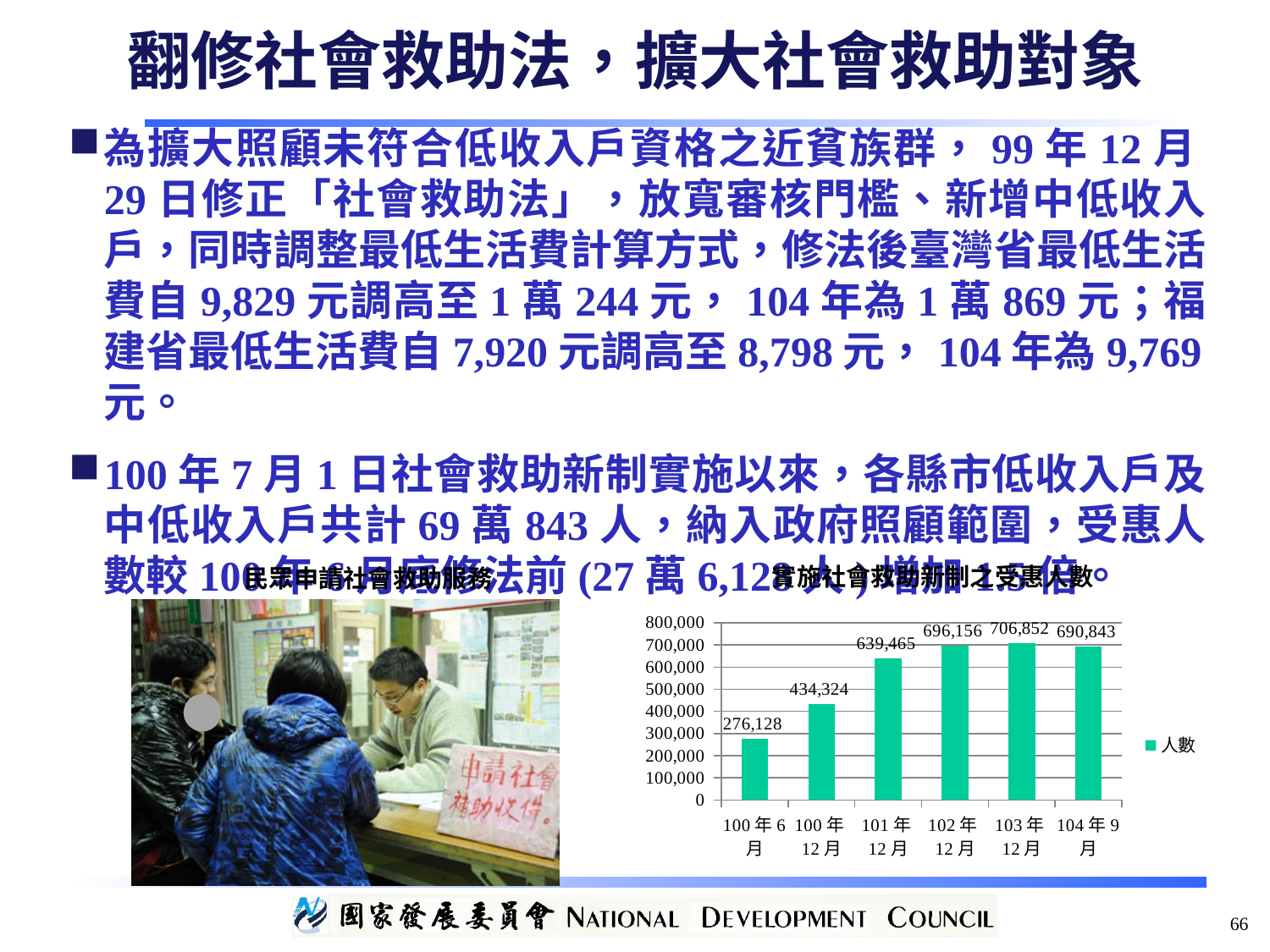
What is the value for 100年6月 in the chart? 276,128 Which category has the highest value in the chart? 103年12月 What type of chart is shown on the slide? bar chart What is the legend entry of the chart? 人數 How many categories are shown on the x axis of the chart? 6 What is the value for 101年12月 in the chart? 639,465 Is the value for 100年12月 greater or less than 500,000? less Which is larger, the value for 102年12月 or the value for 104年9月? 102年12月 Which category has the lowest value in the chart? 100年6月 What is the value for 104年9月 in the chart? 690,843 How many series does the chart legend list? 1 What is the difference between the values for 100年12月 and 100年6月? 158,196